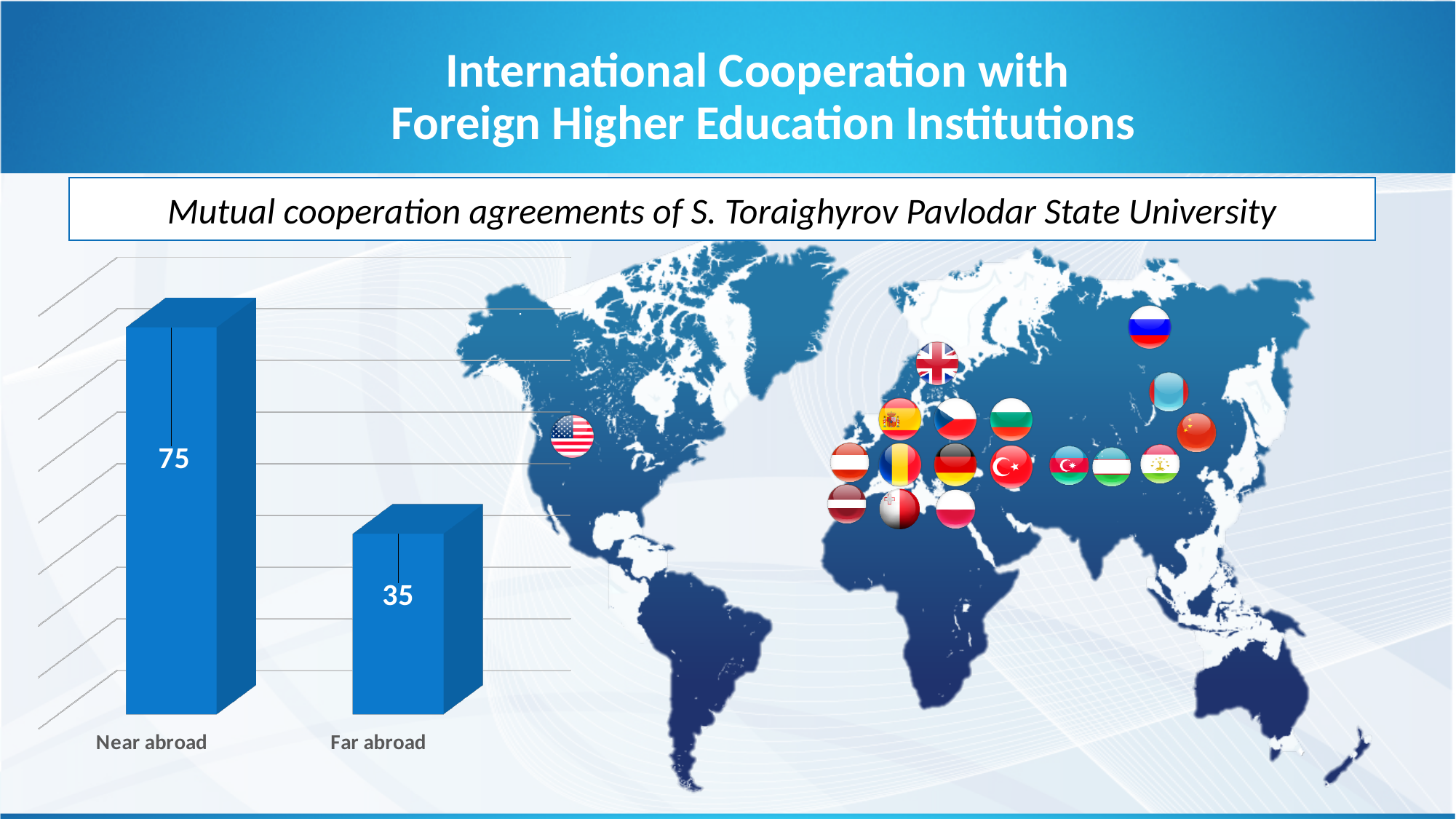
How many categories are shown in the bar chart? 2 What is the total of the two bars in the chart? 110 What colour are the bars in the chart? Blue Which category has the highest value? Near abroad What is the caption above the chart describing the data? Mutual cooperation agreements of S. Toraighyrov Pavlodar State University What is the value for Near abroad? 75 Which category has the lowest value? Far abroad What kind of chart is shown on the slide? Bar chart What is the difference between the values for Near abroad and Far abroad? 40 What is the value for Far abroad? 35 Which is larger, the value for Near abroad or the value for Far abroad? Near abroad